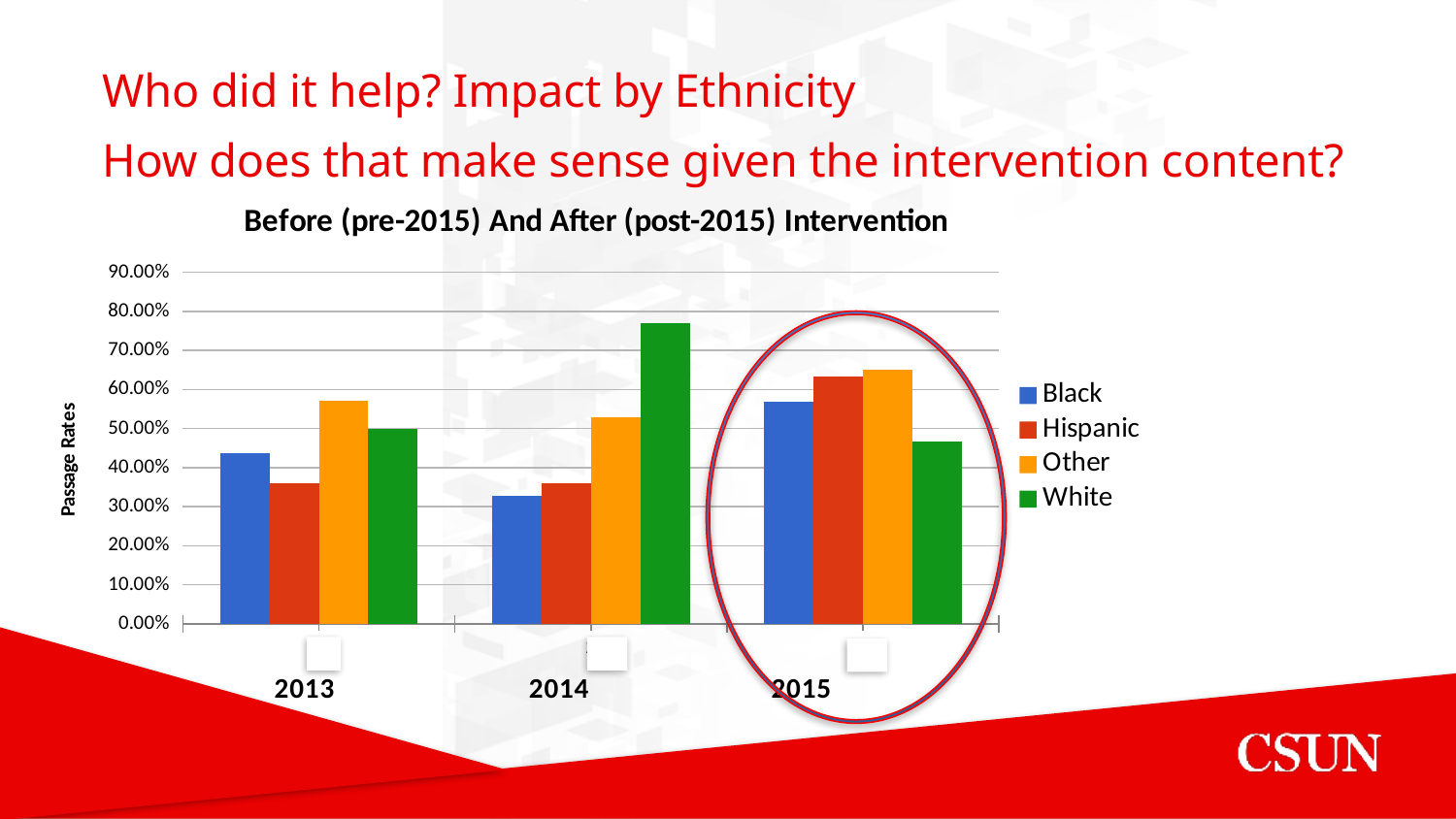
Does the passage rate for Hispanic rise or fall from 2014 to 2015? rise Is the value for Black in 2014 greater or less than 40.00%? less Which is larger, the passage rate for Black in 2013 or for Black in 2015? Black in 2015 Is the value for White in 2014 greater or less than 70.00%? greater What kind of chart is shown on the slide? bar chart Which ethnicity has the lowest passage rate in 2013? Hispanic Which ethnicity has the highest passage rate in 2014? White What is the title of the chart? Before (pre-2015) And After (post-2015) Intervention How many series does the legend list? 4 Which ethnicity has the lowest passage rate in 2015? White How many year categories are shown on the x axis? 3 Is the value for Other in 2013 greater or less than 50.00%? greater